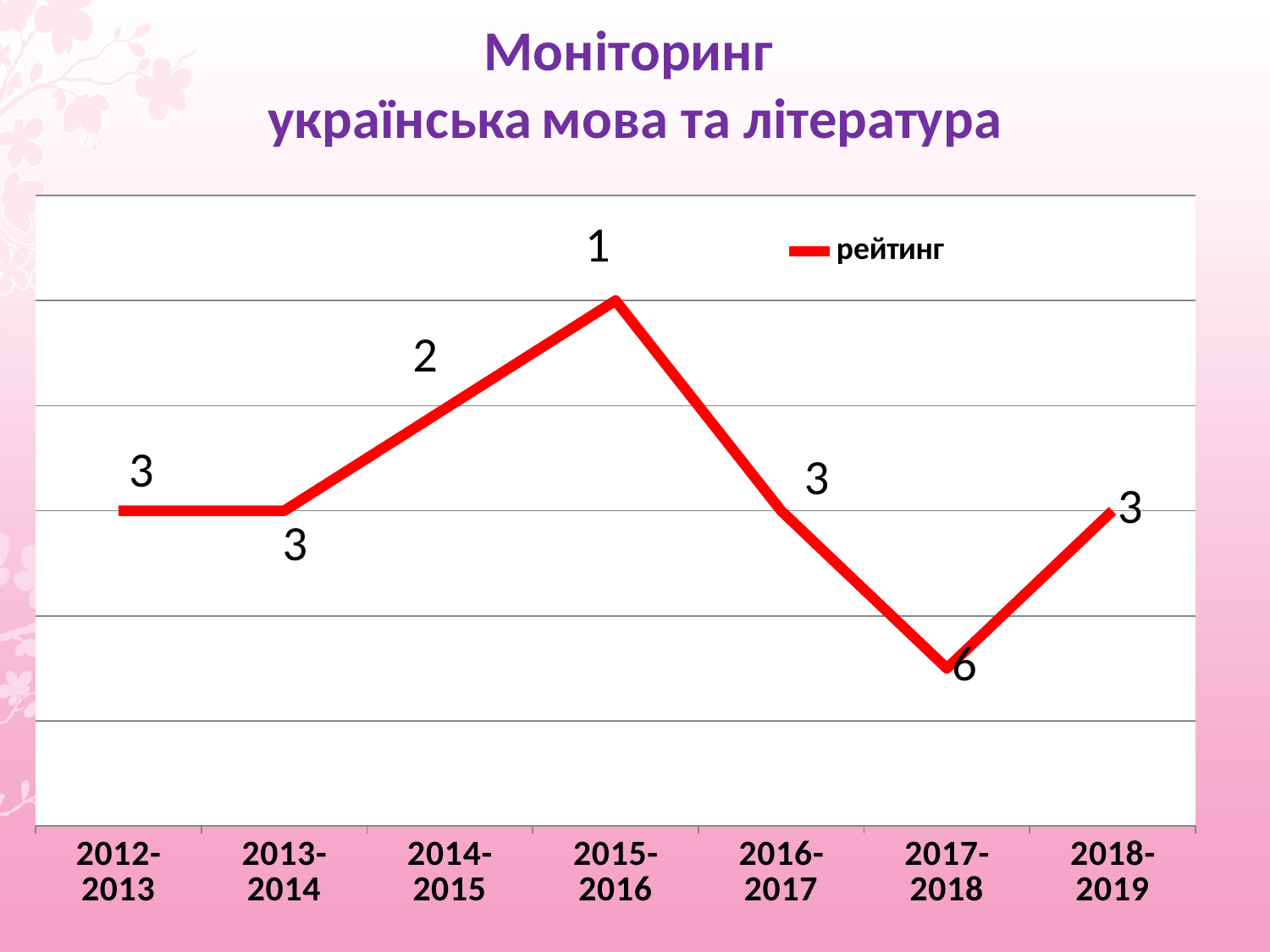
What is the difference between the values for 2017-2018 and 2015-2016? 5 How many school years are plotted on the x axis? 7 What is the name of the series shown in the legend? рейтинг What is the value for 2017-2018? 6 How many series does the legend list? 1 What is the value for 2014-2015? 2 What is the value for 2015-2016? 1 What type of chart is shown on the slide? line chart Which school year has the smallest plotted value? 2017-2018 What is the value for 2018-2019? 3 Which school year has the largest plotted value? 2015-2016